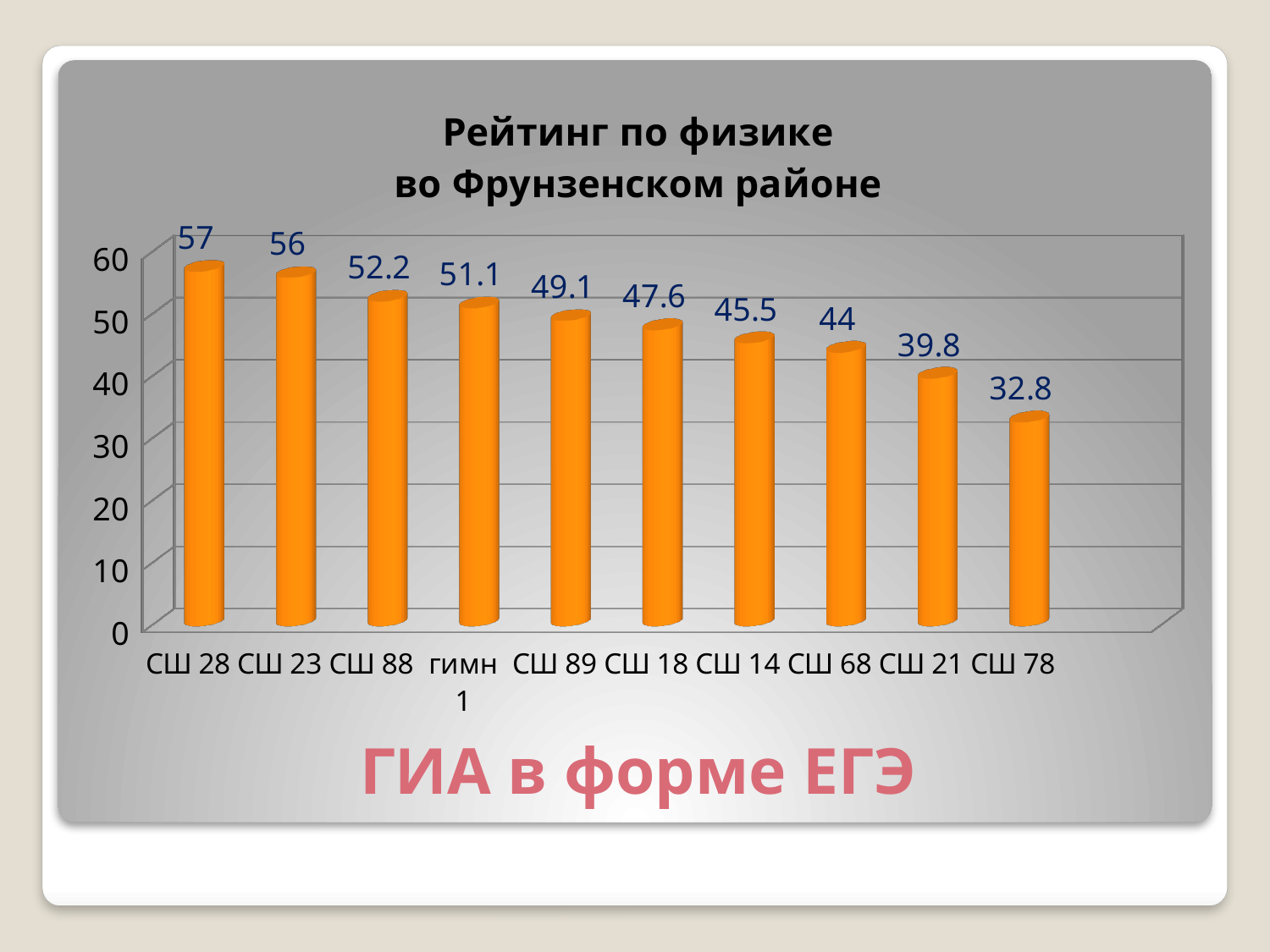
Which school has the highest value? СШ 28 How many schools are shown on the chart? 10 What is the value for СШ 14? 45.5 What is the value for гимн 1? 51.1 What kind of chart is shown on the slide? bar chart Which school has the lowest value? СШ 78 Is the value for СШ 21 greater or less than 40? less Which is larger, the value for СШ 18 or the value for СШ 68? СШ 18 Do the values rise or fall from left to right along the x axis? fall What is the value for СШ 28? 57 What is the difference between the values for СШ 28 and СШ 78? 24.2 What is the difference between the values for СШ 88 and СШ 89? 3.1